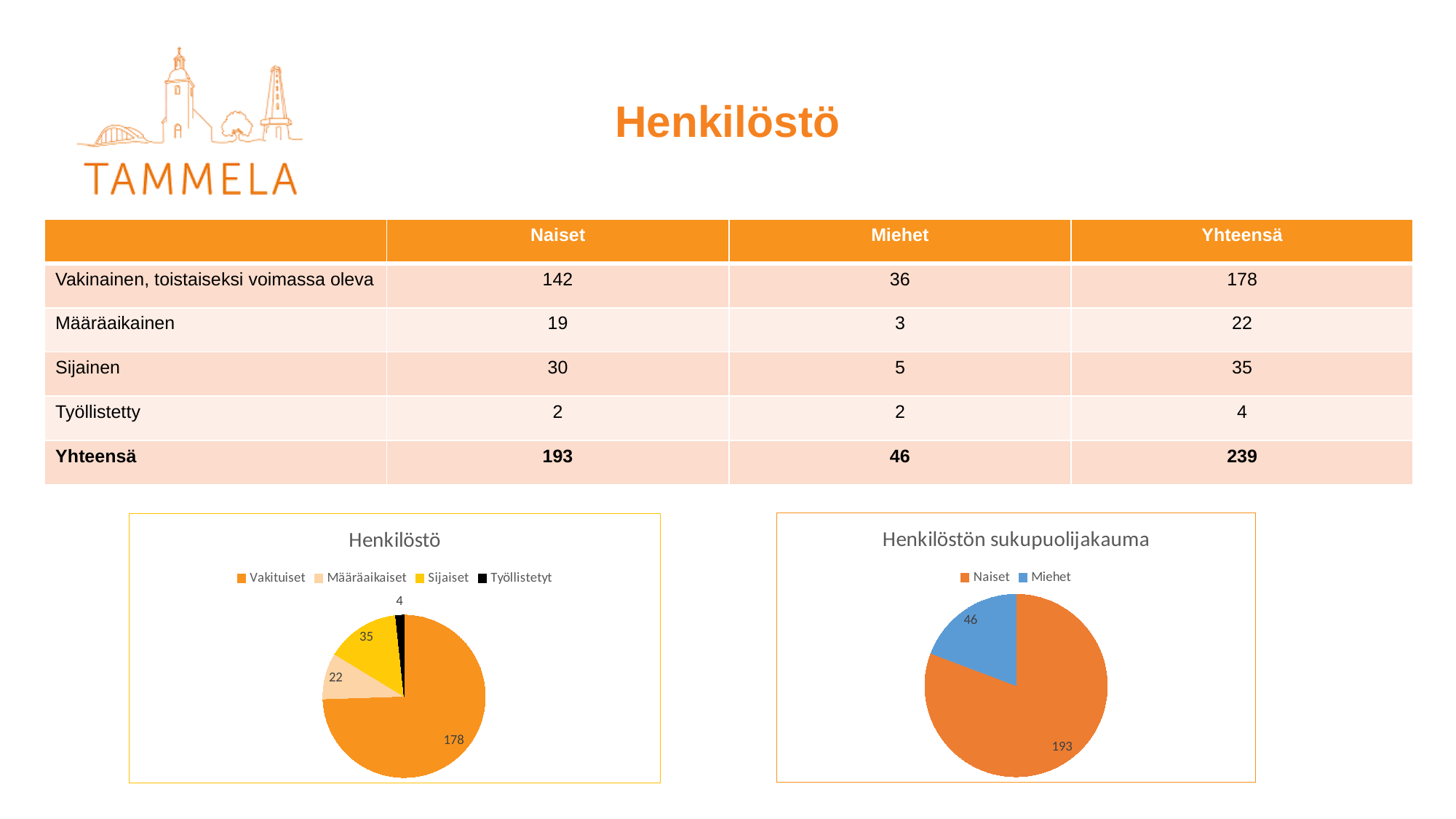
In the chart titled "Henkilöstö", what is the value for Sijaiset? 35 In the chart titled "Henkilöstö", what is the difference between Sijaiset and Määräaikaiset? 13 What kind of chart is the chart titled "Henkilöstön sukupuolijakauma"? Pie chart In the chart titled "Henkilöstö", which category has the largest slice? Vakituiset In the chart titled "Henkilöstö", how many categories does the legend list? 4 In the chart titled "Henkilöstö", which category has the smallest slice? Työllistetyt In the chart titled "Henkilöstön sukupuolijakauma", what is the difference between Naiset and Miehet? 147 In the chart titled "Henkilöstön sukupuolijakauma", which colour represents Miehet? Blue In the chart titled "Henkilöstö", what is the value for Määräaikaiset? 22 In the chart titled "Henkilöstön sukupuolijakauma", what is the value for Naiset? 193 In the chart titled "Henkilöstö", what is the value for Vakituiset? 178 In the chart titled "Henkilöstön sukupuolijakauma", what is the value for Miehet? 46